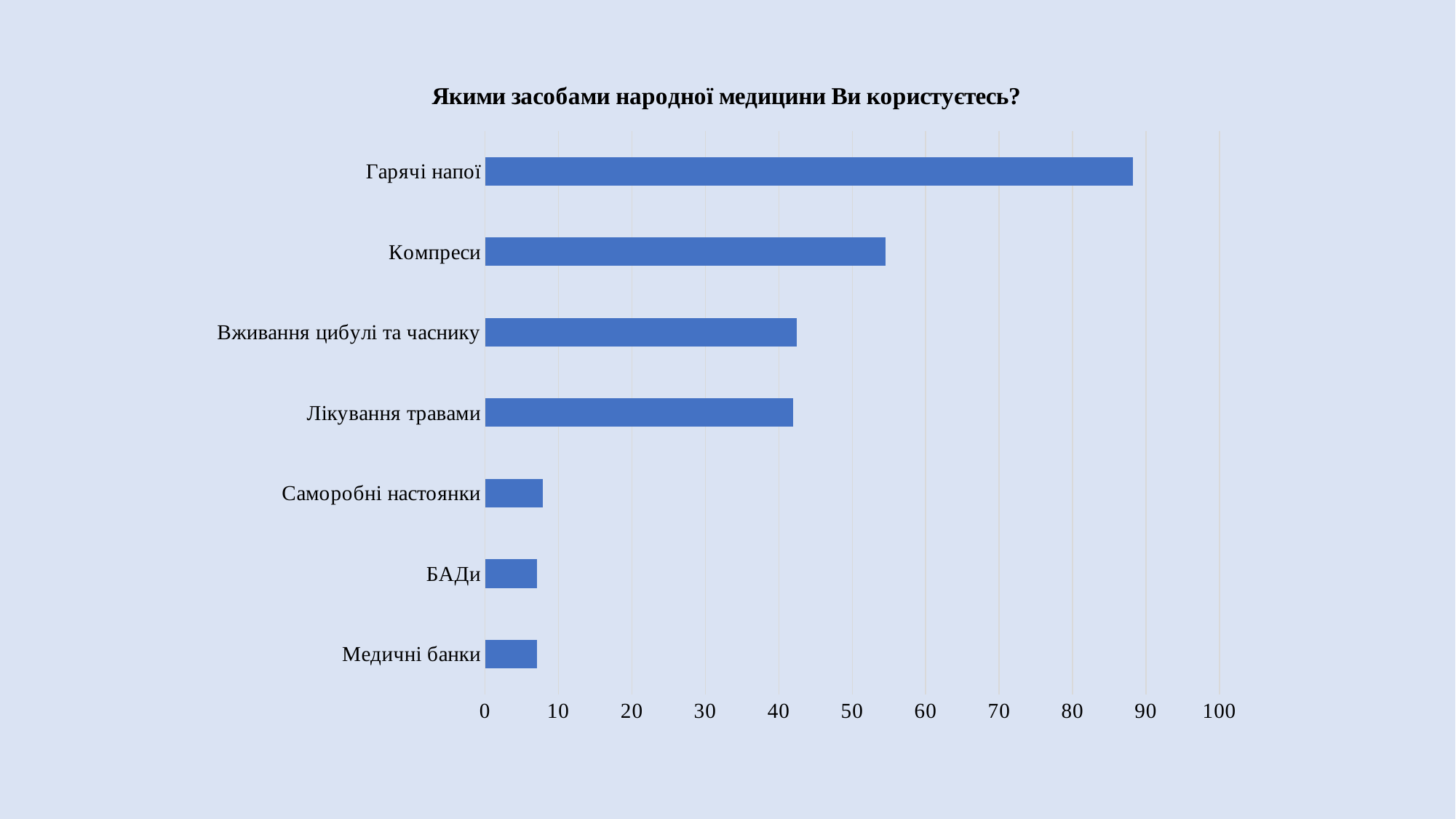
Which is larger, the value for БАДи or the value for Вживання цибулі та часнику? Вживання цибулі та часнику Which is larger, the value for Компреси or the value for Лікування травами? Компреси What is the title of the chart? Якими засобами народної медицини Ви користуєтесь? Is the value for Вживання цибулі та часнику greater or less than 50? less Is the value for Компреси greater or less than 50? greater Is the value for Лікування травами greater or less than 30? greater Which category has the highest value? Гарячі напої How many categories are shown in the chart? 7 What kind of chart is shown on the slide? bar chart